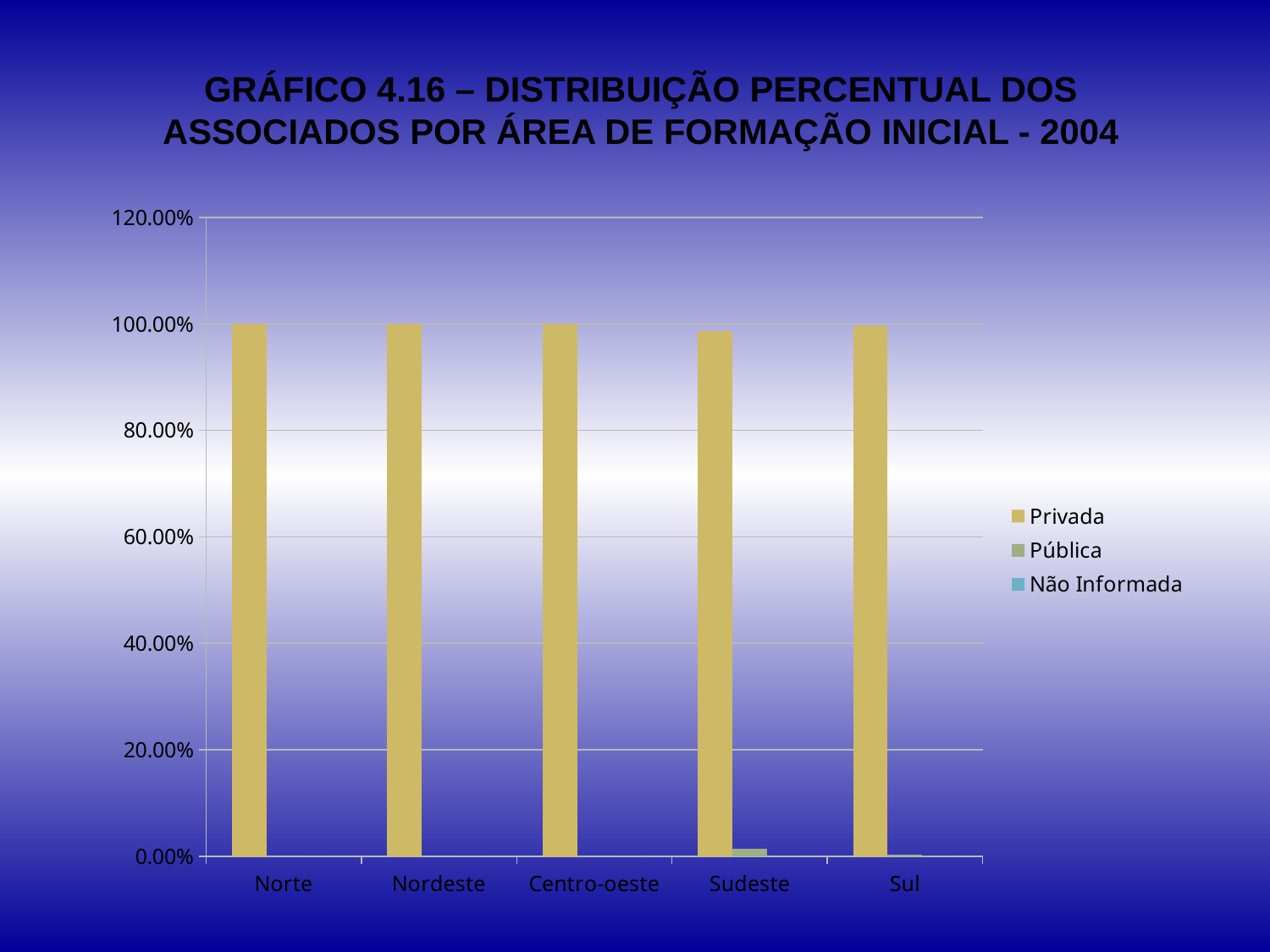
How many series does the legend list? 3 Which series are listed in the legend? Privada, Pública, Não Informada Is the Pública value for Sudeste greater or less than 20.00%? less Which is larger, the Privada value for Norte or the Privada value for Sudeste? Norte Which region has the highest Pública value? Sudeste Which series has the tallest bars in every region? Privada What is the highest value shown on the y axis? 120.00% What kind of chart is shown on the slide? bar chart Which is larger, the Pública value for Sudeste or the Pública value for Sul? Sudeste How many regions (categories) are shown on the x axis? 5 Is the Privada value for Norte greater or less than 80.00%? greater Is the Privada value for Sudeste greater or less than 60.00%? greater